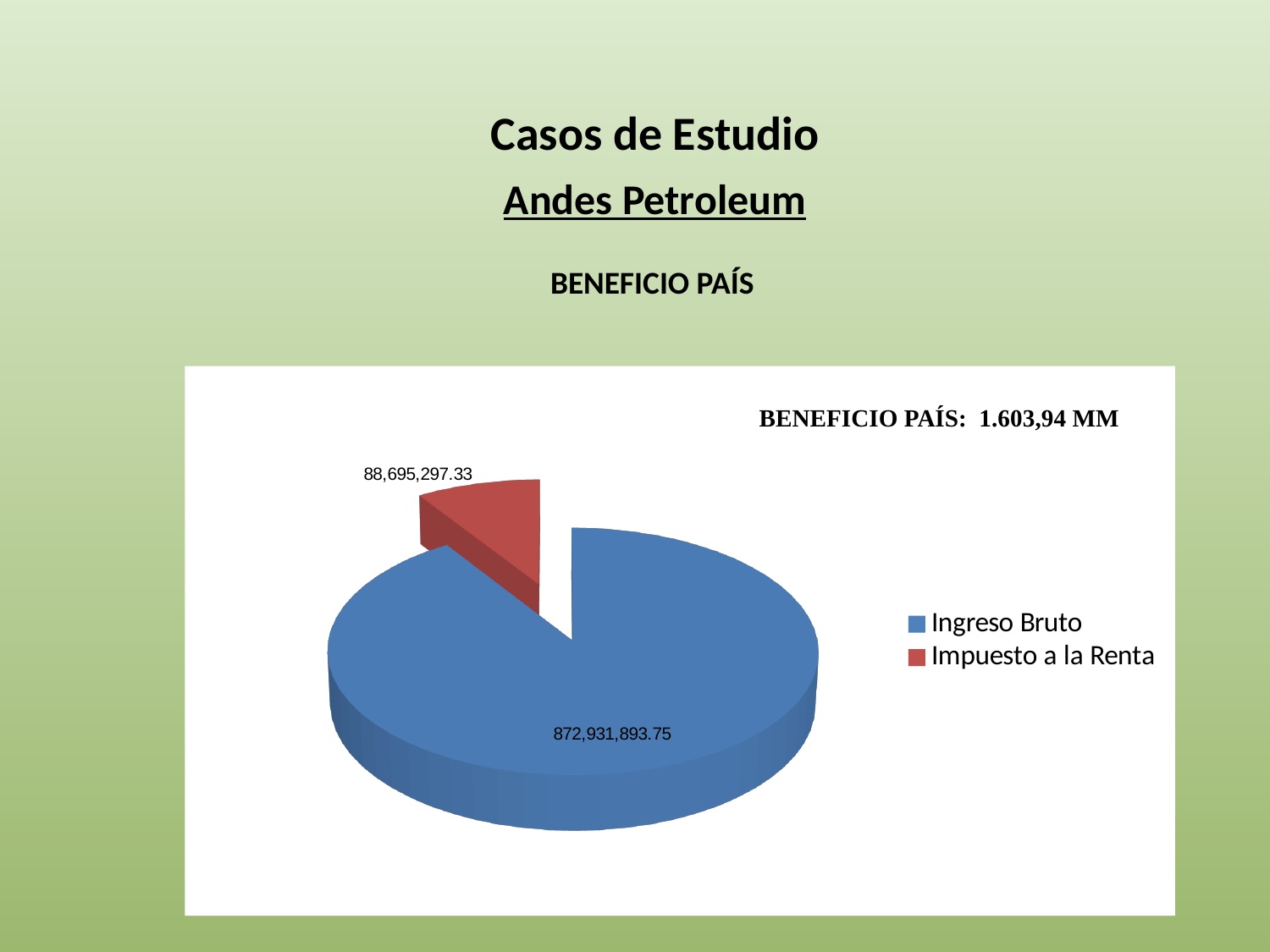
What is the value for Impuesto a la Renta in the pie chart? 88,695,297.33 Which is larger, Ingreso Bruto or Impuesto a la Renta? Ingreso Bruto What BENEFICIO PAÍS figure is printed in the chart area? 1.603,94 MM How many entries does the legend list? 2 Which slice of the pie chart is the largest? Ingreso Bruto Which slice of the pie chart is the smallest? Impuesto a la Renta What is the value for Ingreso Bruto in the pie chart? 872,931,893.75 What is the total of the two values shown in the pie chart? 961,627,191.08 What type of chart is shown on the slide? Pie chart How many slices does the pie chart have? 2 What is the difference between the Ingreso Bruto value and the Impuesto a la Renta value? 784,236,596.42 What colour is the Impuesto a la Renta slice? Red